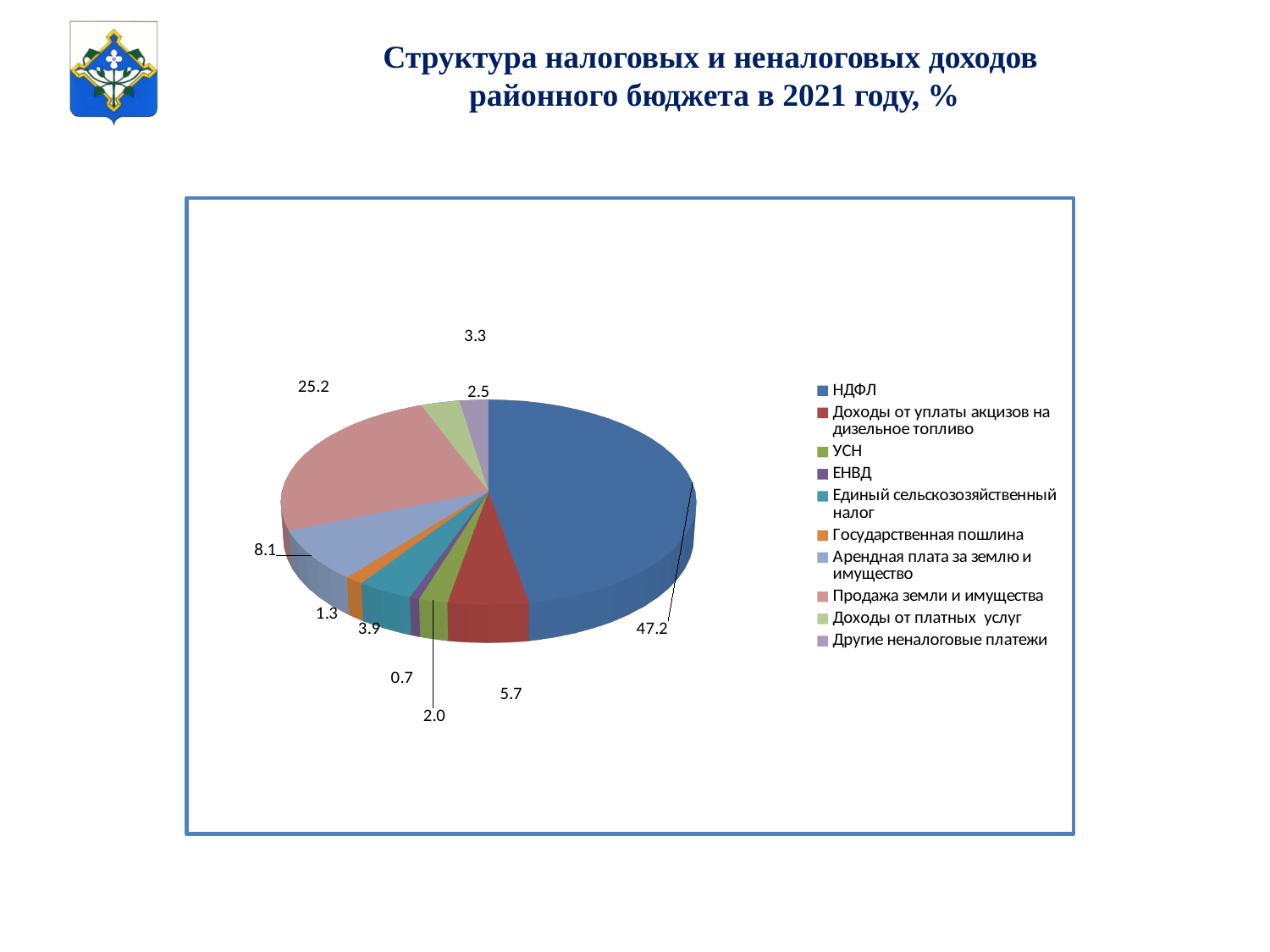
What is the value for Продажа земли и имущества? 25.2 What is the value for Арендная плата за землю и имущество? 8.1 What is the value for Доходы от уплаты акцизов на дизельное топливо? 5.7 How many categories does the legend list? 10 What is the value for ЕНВД? 0.7 What is the value for НДФЛ? 47.2 What is the title of the chart on the slide? Структура налоговых и неналоговых доходов районного бюджета в 2021 году, % What kind of chart is shown on the slide? pie chart Which is larger, the value for Единый сельскозозяйственный налог or the value for Доходы от платных услуг? Единый сельскозозяйственный налог Which category has the largest share of the pie? НДФЛ Which category has the smallest share of the pie? ЕНВД What is the difference between the values for НДФЛ and Продажа земли и имущества? 22.0